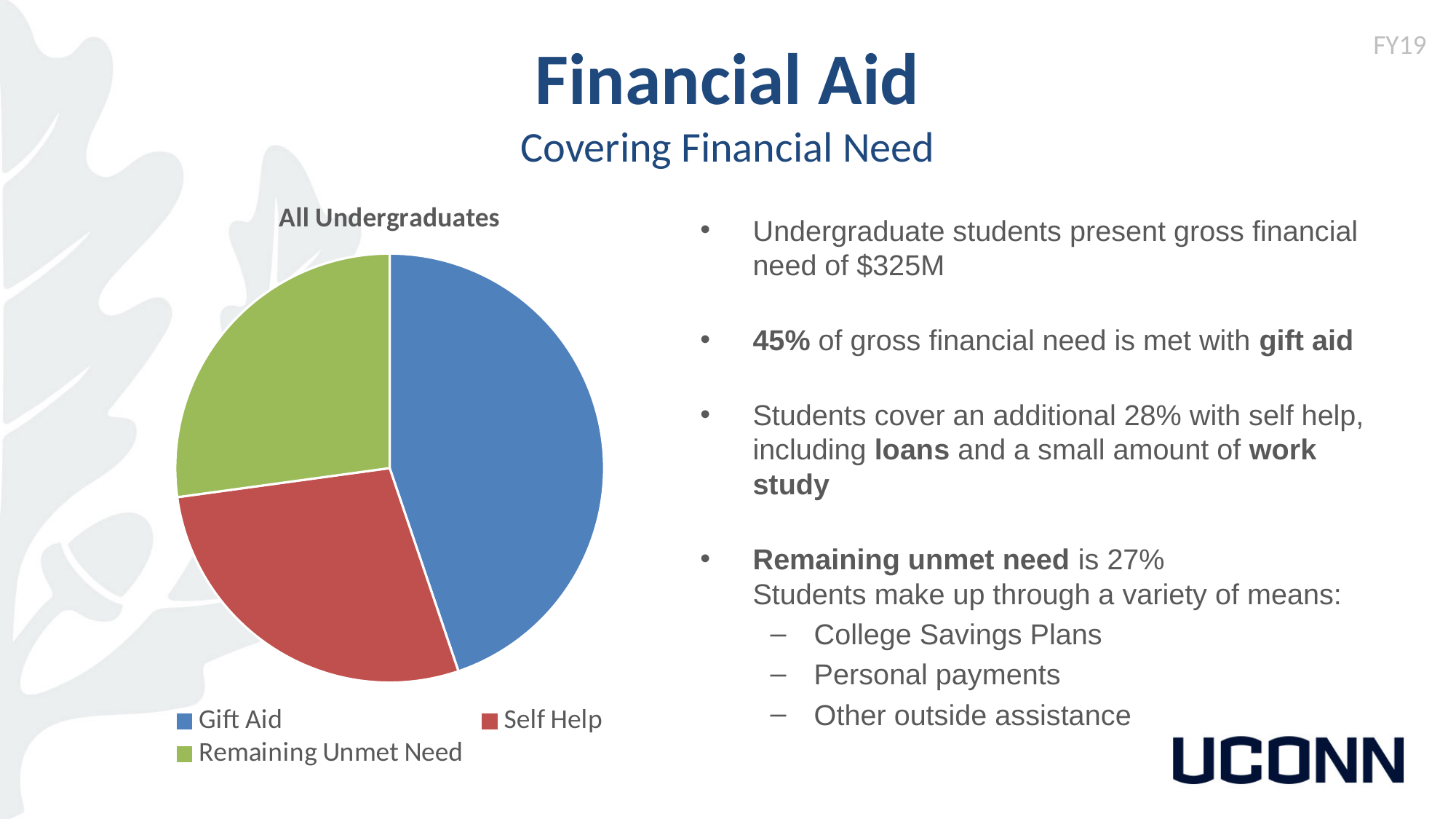
Which slice of the pie chart is the largest? Gift Aid Is the Gift Aid slice greater or less than half of the pie? less How many entries does the legend of the pie chart list? 3 What share of the pie does Self Help represent? 28% What share of the pie does Gift Aid represent? 45% Which is larger in the pie chart, Gift Aid or Remaining Unmet Need? Gift Aid Which is larger in the pie chart, Gift Aid or Self Help? Gift Aid Which colour represents Remaining Unmet Need in the pie chart? green How many slices does the pie chart have? 3 What kind of chart is shown on the slide? pie chart What share of the pie does Remaining Unmet Need represent? 27% What is the title of the pie chart? All Undergraduates